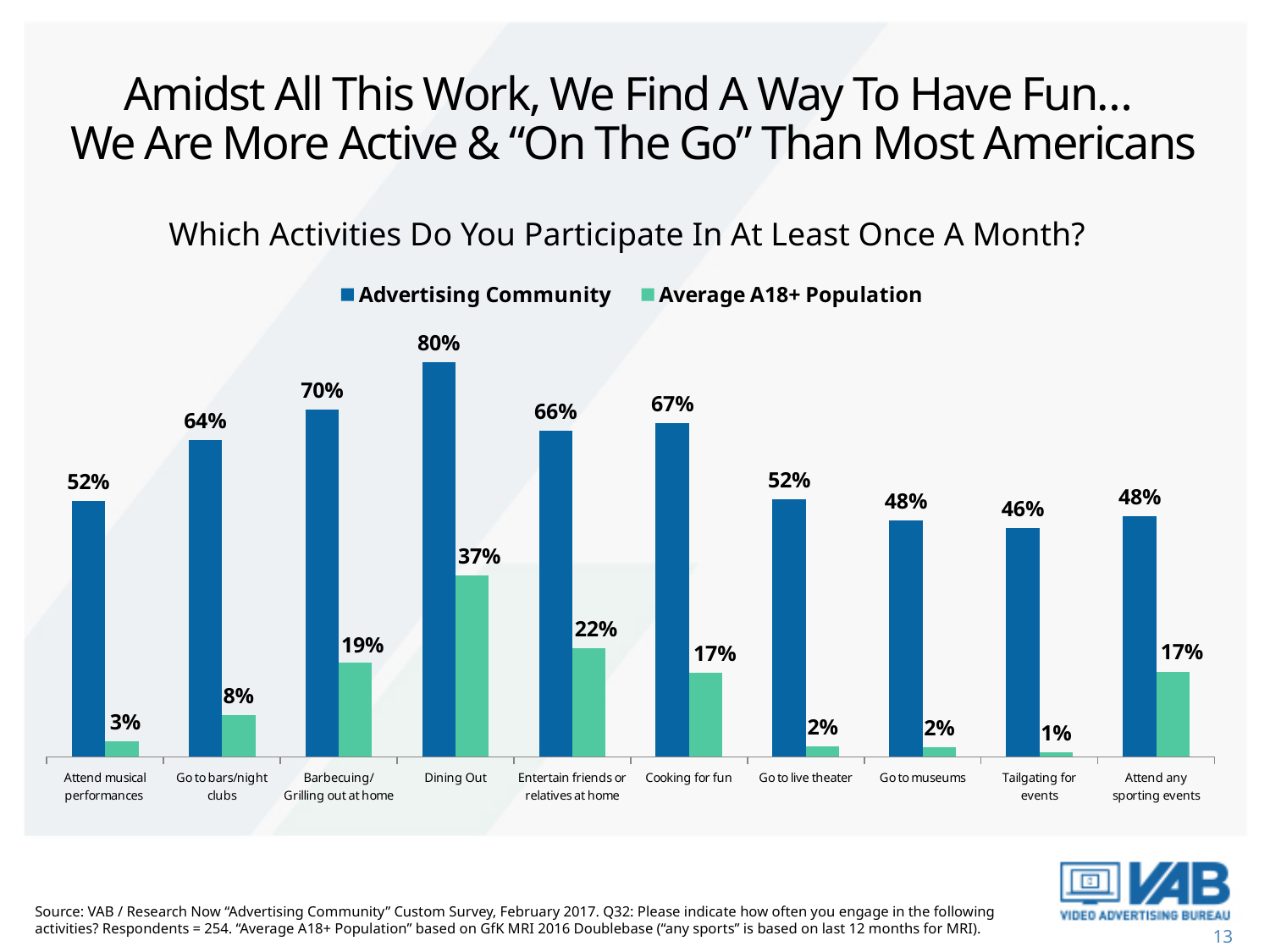
Which activity has the lowest Average A18+ Population value? Tailgating for events Which series is shown in green in the legend? Average A18+ Population What is the Average A18+ Population value for Barbecuing/Grilling out at home? 19% How many series does the legend list? 2 What is the Advertising Community value for Tailgating for events? 46% How many activities are shown on the x axis? 10 Which is larger: the Advertising Community value for Cooking for fun or for Entertain friends or relatives at home? Cooking for fun What is the difference between the Advertising Community and Average A18+ Population values for Dining Out? 43% What is the Advertising Community value for Dining Out? 80% Which activity has the highest Advertising Community value? Dining Out What kind of chart is shown on the slide? Bar chart What is the difference between the Advertising Community values for Barbecuing/Grilling out at home and Attend musical performances? 18%